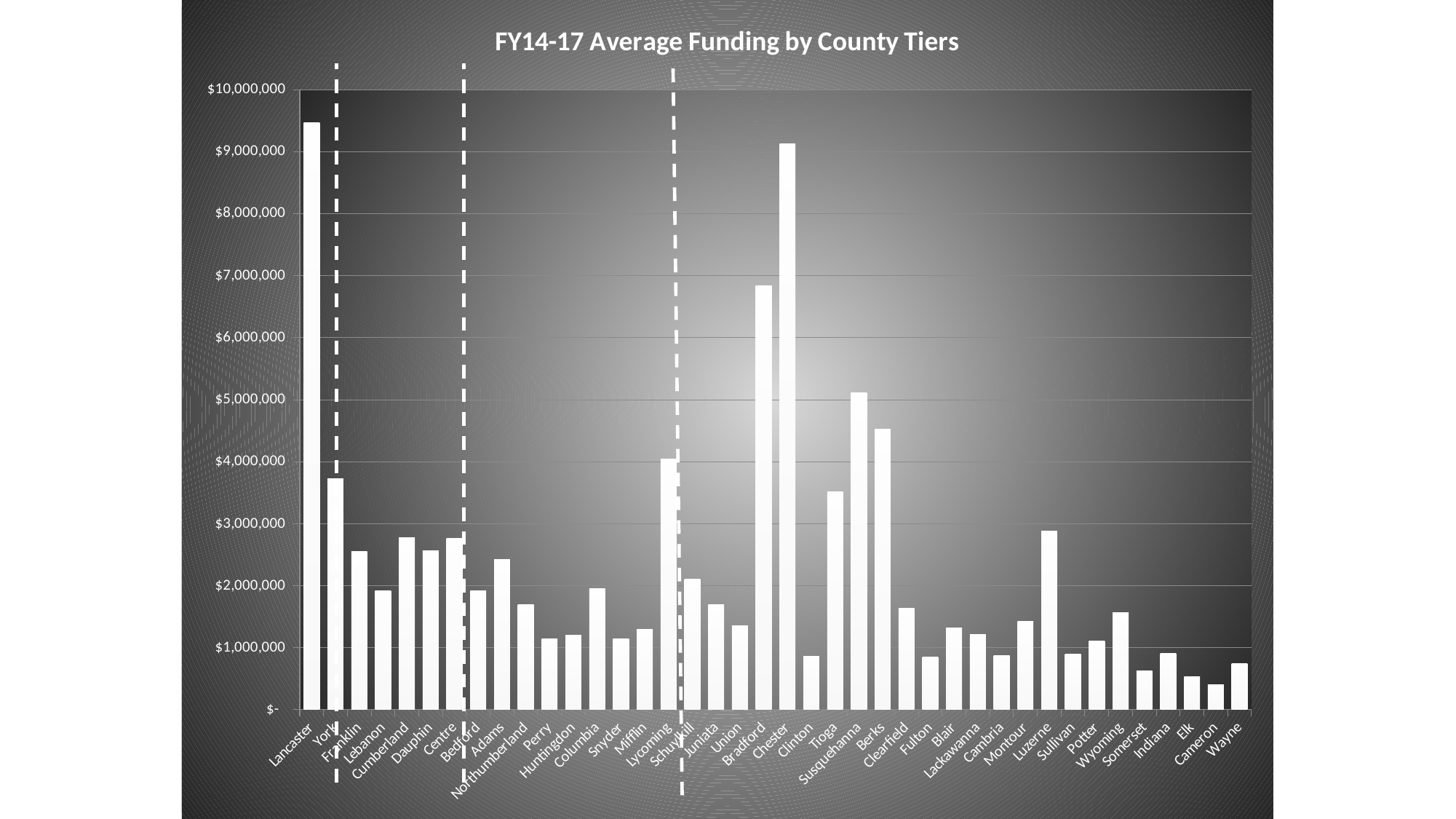
Which county has the highest average funding? Lancaster Is the value for Lancaster greater or less than $9,000,000? greater What is the title of the chart? FY14-17 Average Funding by County Tiers Is the value for Berks greater or less than $4,000,000? greater Which has the larger value, Susquehanna or Berks? Susquehanna Which has the larger value, Chester or Bradford? Chester Is the value for Luzerne greater or less than $3,000,000? less Which county has the lowest average funding? Cameron How many counties are plotted on the x axis? 40 What kind of chart is shown on the slide? bar chart